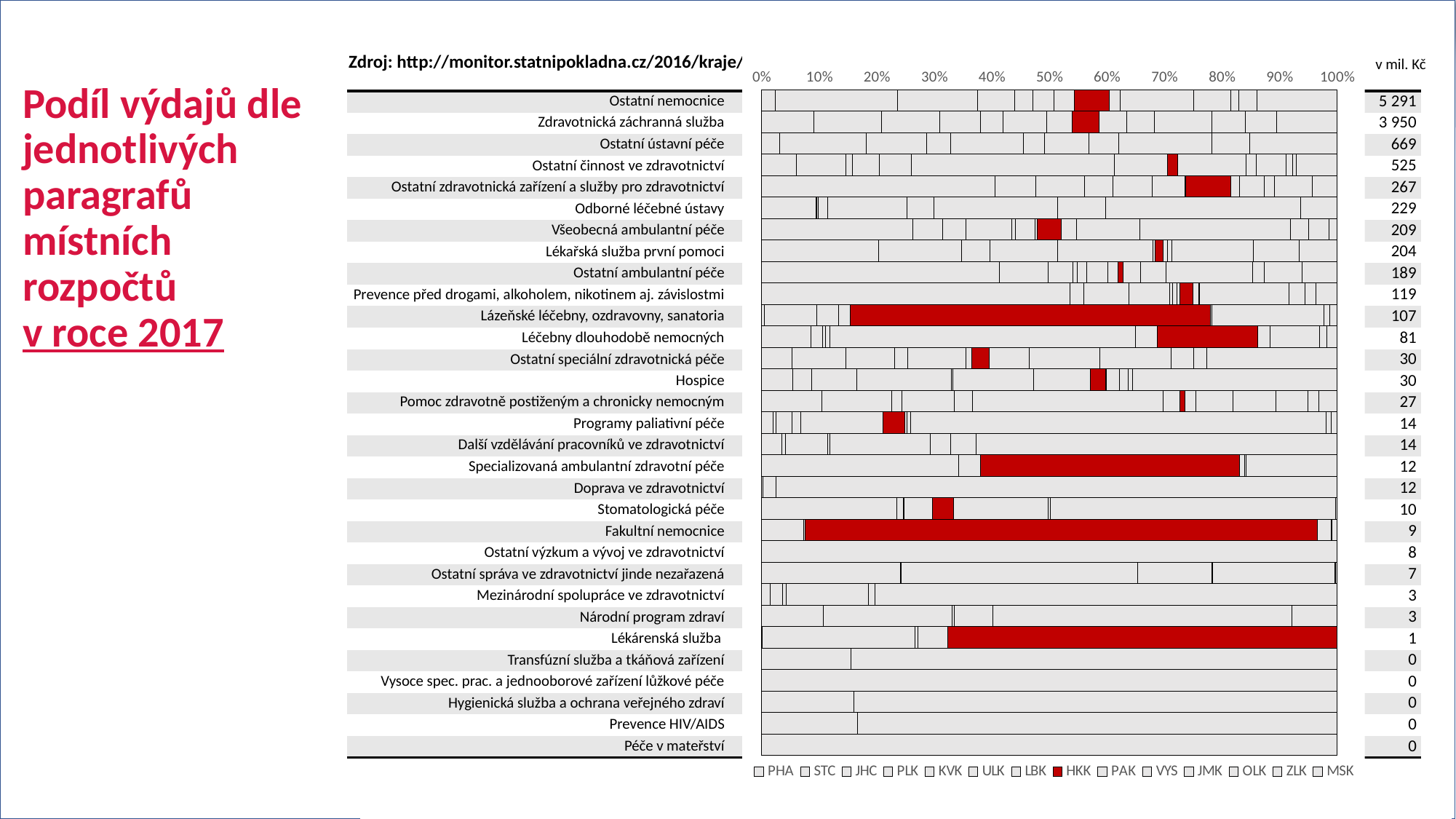
Which has the larger total in mil. Kč: Ostatní ústavní péče or Ostatní činnost ve zdravotnictví? Ostatní ústavní péče Which region in the legend is highlighted in red? HKK How many series (regions) does the legend list? 14 Is the HKK share of Lékárenská služba greater or less than 60%? greater Is the HKK share of Fakultní nemocnice greater or less than 80%? greater How many categories (paragraphs) are plotted in the chart? 31 What kind of chart is shown on the slide? stacked bar chart What is the difference in mil. Kč between Ostatní nemocnice and Zdravotnická záchranná služba? 1 341 What is the total in mil. Kč shown for Ostatní nemocnice? 5 291 What is the total in mil. Kč shown for Zdravotnická záchranná služba? 3 950 Which category has the highest total in mil. Kč? Ostatní nemocnice What is the total in mil. Kč shown for Lázeňské léčebny, ozdravovny, sanatoria? 107